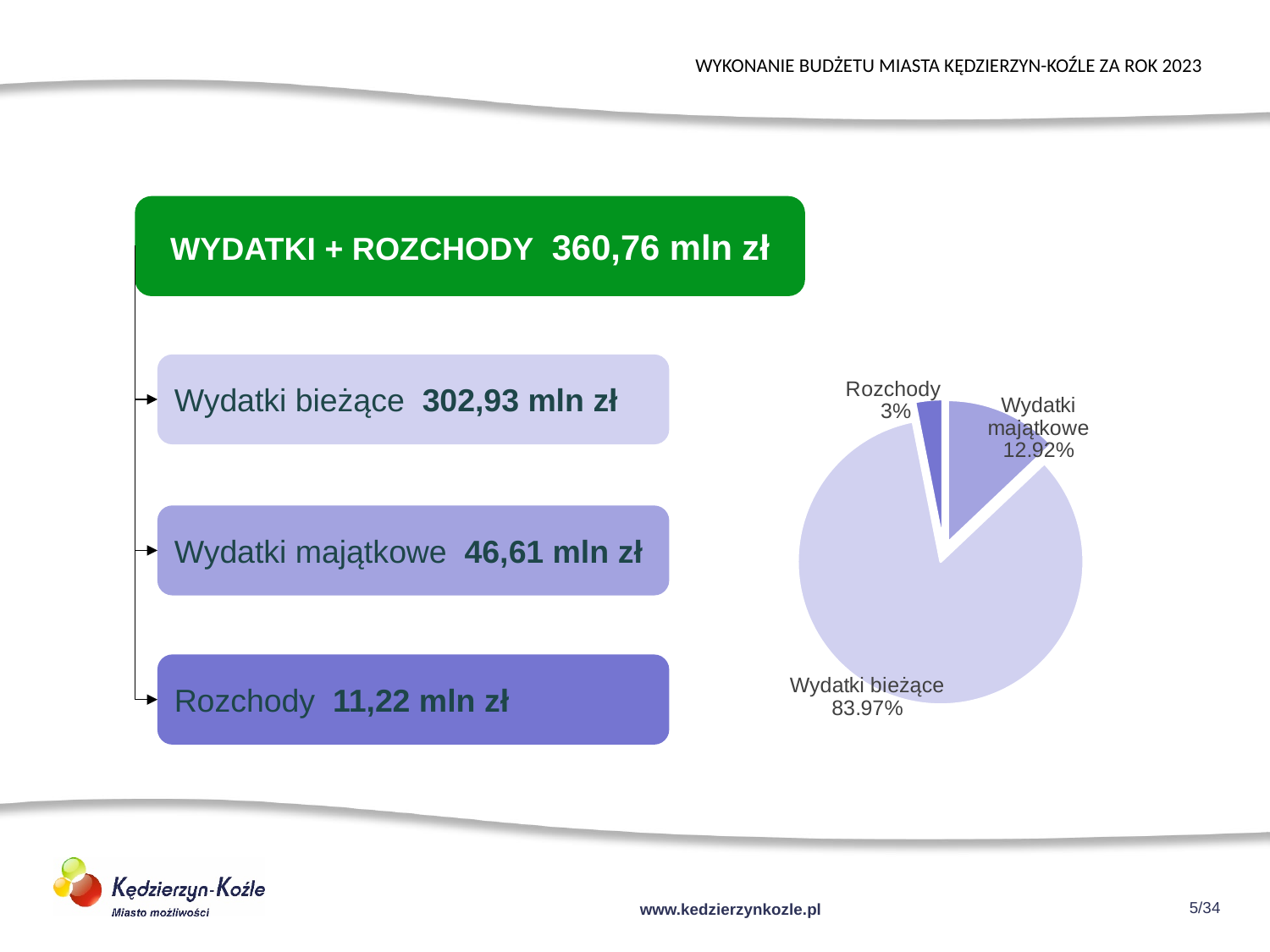
What share of the pie does Wydatki majątkowe represent? 12.92% What is the difference in percentage points between the Wydatki bieżące and Wydatki majątkowe slices? 71.05 What kind of chart is shown on the slide? pie chart How many slices does the pie chart have? 3 Which slice of the pie chart is the largest? Wydatki bieżące Which slice of the pie chart is the smallest? Rozchody Which slice of the pie chart is drawn in the lightest shade? Wydatki bieżące What share of the pie does Rozchody represent? 3% What share of the pie does Wydatki bieżące represent? 83.97% Which is larger in the pie chart, Wydatki majątkowe or Rozchody? Wydatki majątkowe What is the difference in percentage points between the Wydatki majątkowe and Rozchody slices? 9.92 Which slice of the pie chart is drawn in the darkest shade of purple? Rozchody